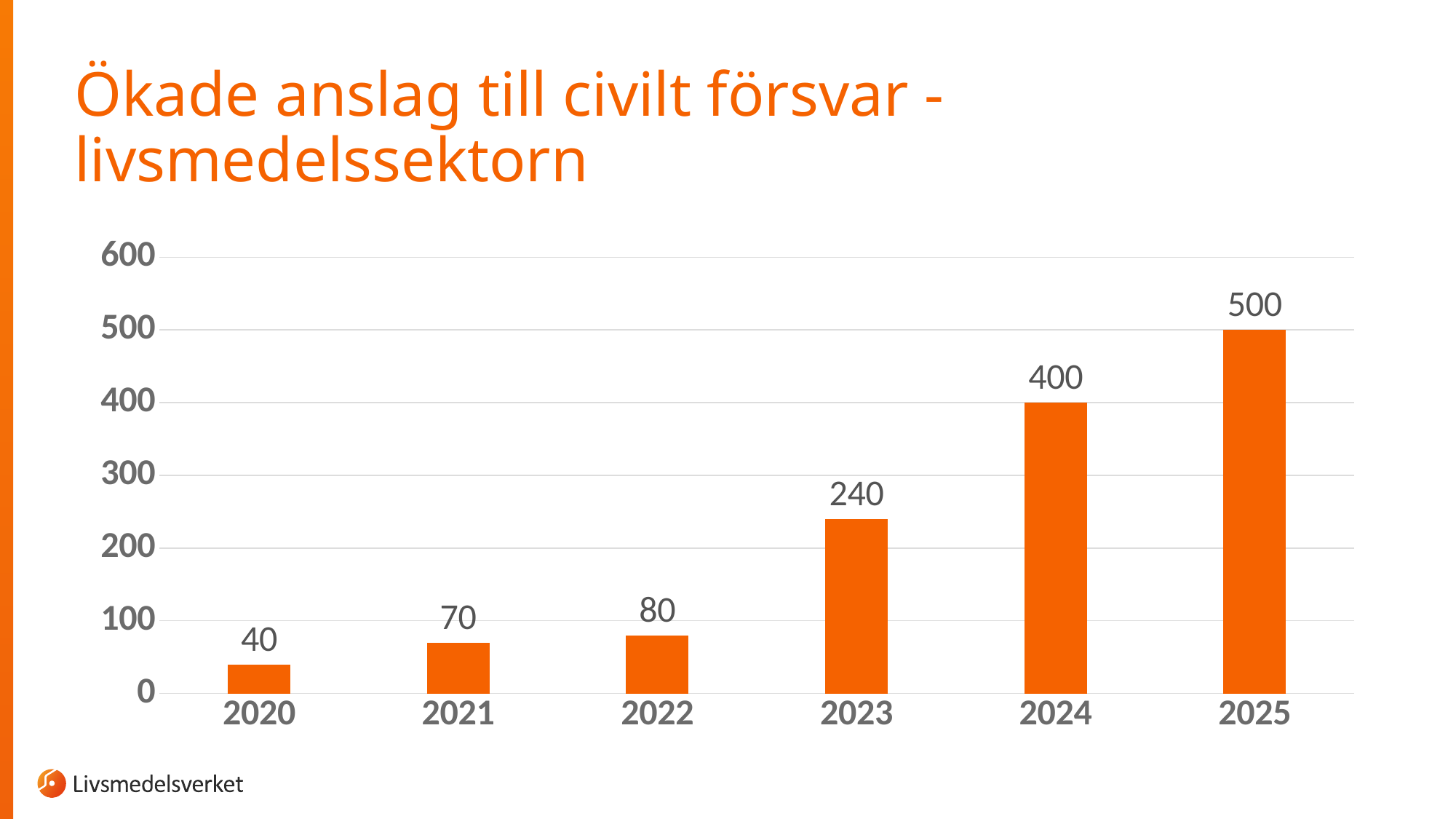
What is the value for 2025? 500 How many years are shown on the x axis? 6 Do the values rise or fall from 2020 to 2025? rise What is the difference between the values for 2022 and 2021? 10 What kind of chart is shown on the slide? bar chart What is the value for 2023? 240 Which is larger, the value for 2024 or the value for 2023? 2024 Which year has the lowest value? 2020 What is the value for 2020? 40 Is the value for 2023 greater or less than 200? greater What is the difference between the values for 2024 and 2023? 160 Which year has the highest value? 2025